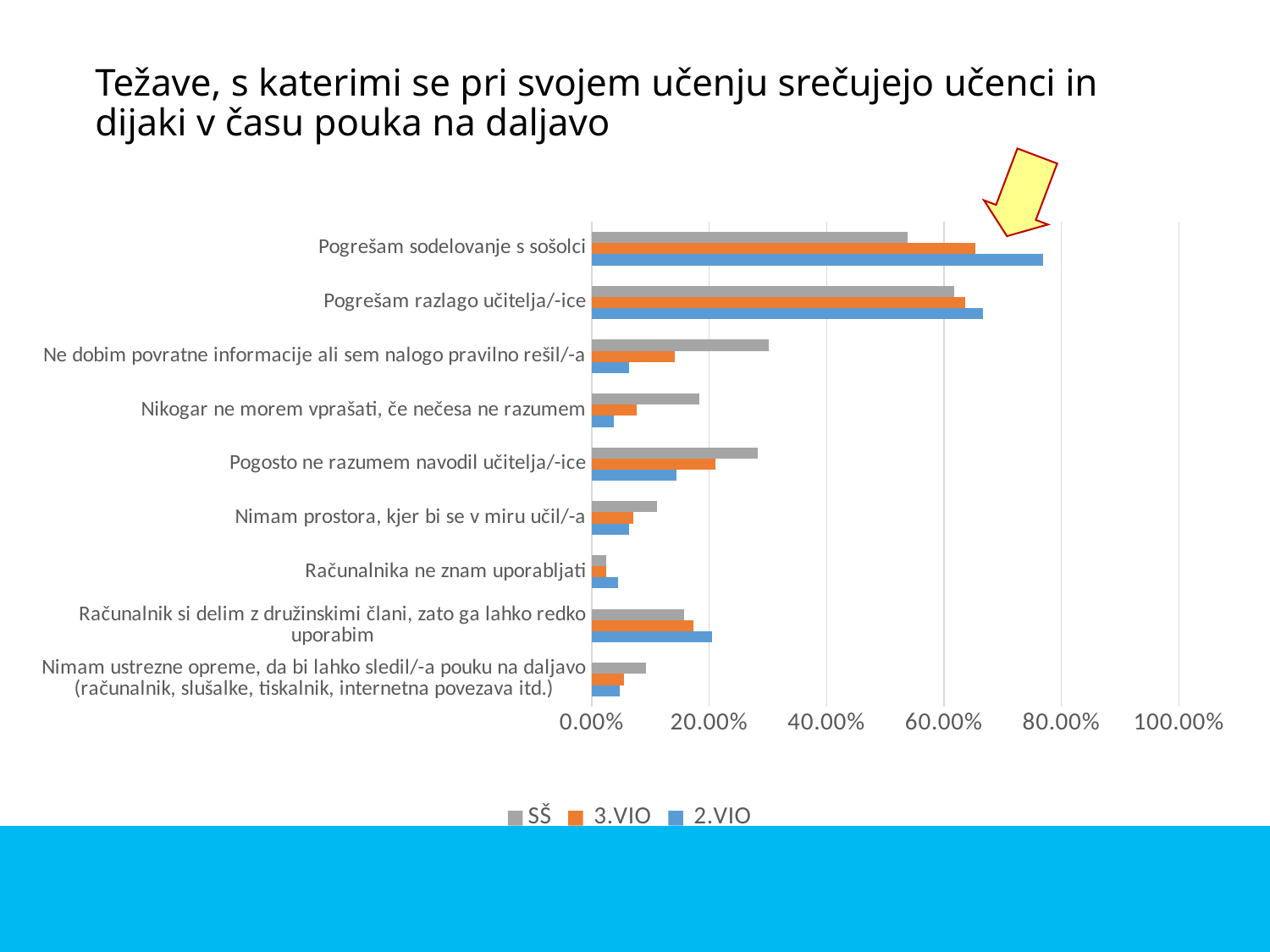
Which colour represents the 2.VIO series in the legend? blue How many categories are plotted on the chart? 9 Which category has the highest 2.VIO value? Pogrešam sodelovanje s sošolci How many series does the legend list? 3 Is the SŠ value for "Ne dobim povratne informacije ali sem nalogo pravilno rešil/-a" greater or less than 20.00%? greater Is the 3.VIO value for "Računalnika ne znam uporabljati" greater or less than 20.00%? less Is the 2.VIO value for "Ne dobim povratne informacije ali sem nalogo pravilno rešil/-a" greater or less than 20.00%? less For "Pogrešam sodelovanje s sošolci", which series has the larger value, 2.VIO or SŠ? 2.VIO Which category has the lowest SŠ value? Računalnika ne znam uporabljati Which category has the highest SŠ value? Pogrešam razlago učitelja/-ice What kind of chart is shown on the slide? bar chart